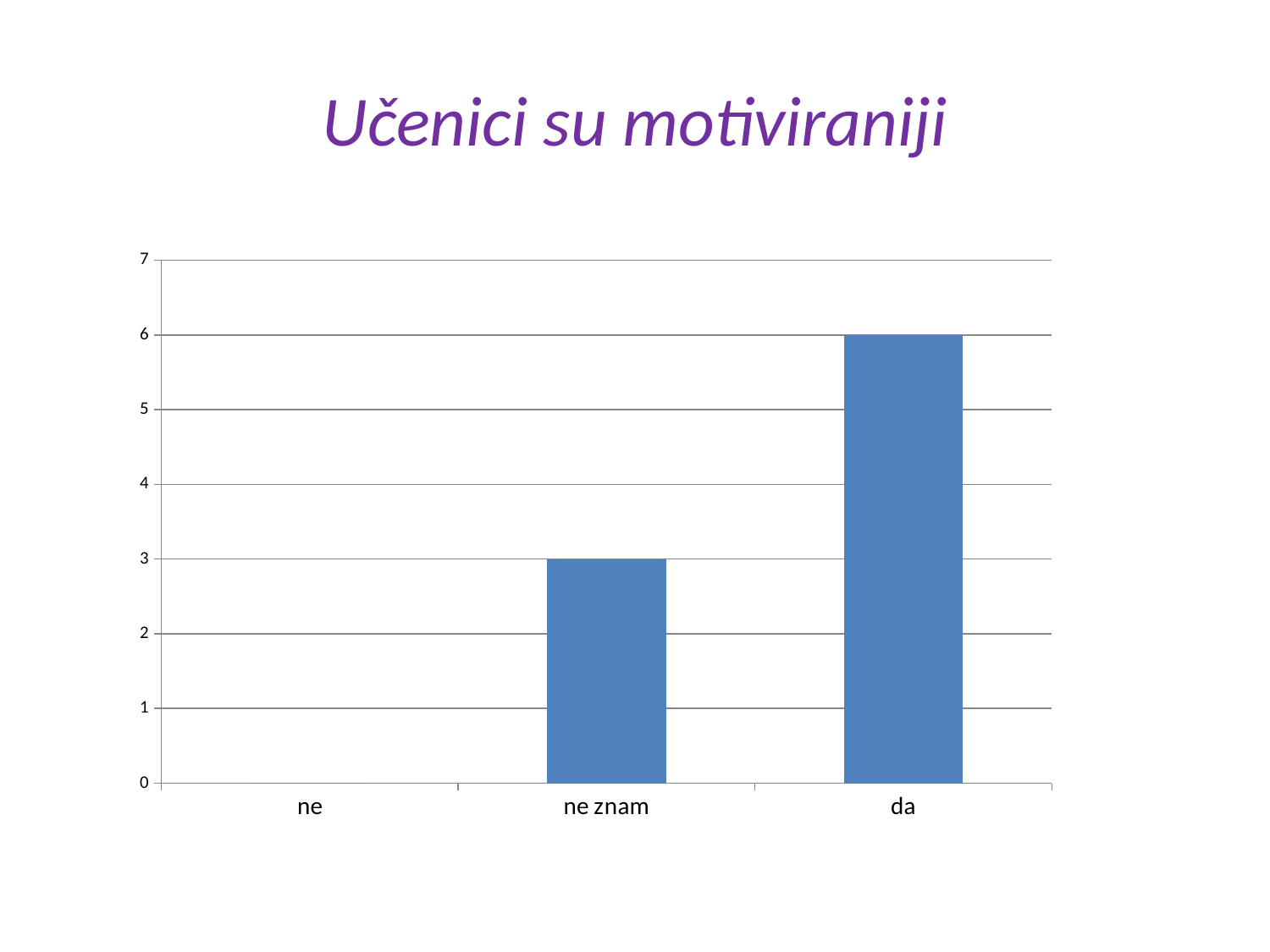
What is the title of the slide? Učenici su motiviraniji What is the value for "da"? 6 How many categories are shown on the x axis? 3 Which category has the lowest value? ne What is the value for "ne"? 0 Which is larger, the value for "ne znam" or the value for "da"? da Is the value for "ne znam" greater or less than 4? less What is the value for "ne znam"? 3 What is the difference between the values for "da" and "ne znam"? 3 What kind of chart is shown on the slide? bar chart Which category has the highest value? da Is the value for "da" greater or less than 5? greater